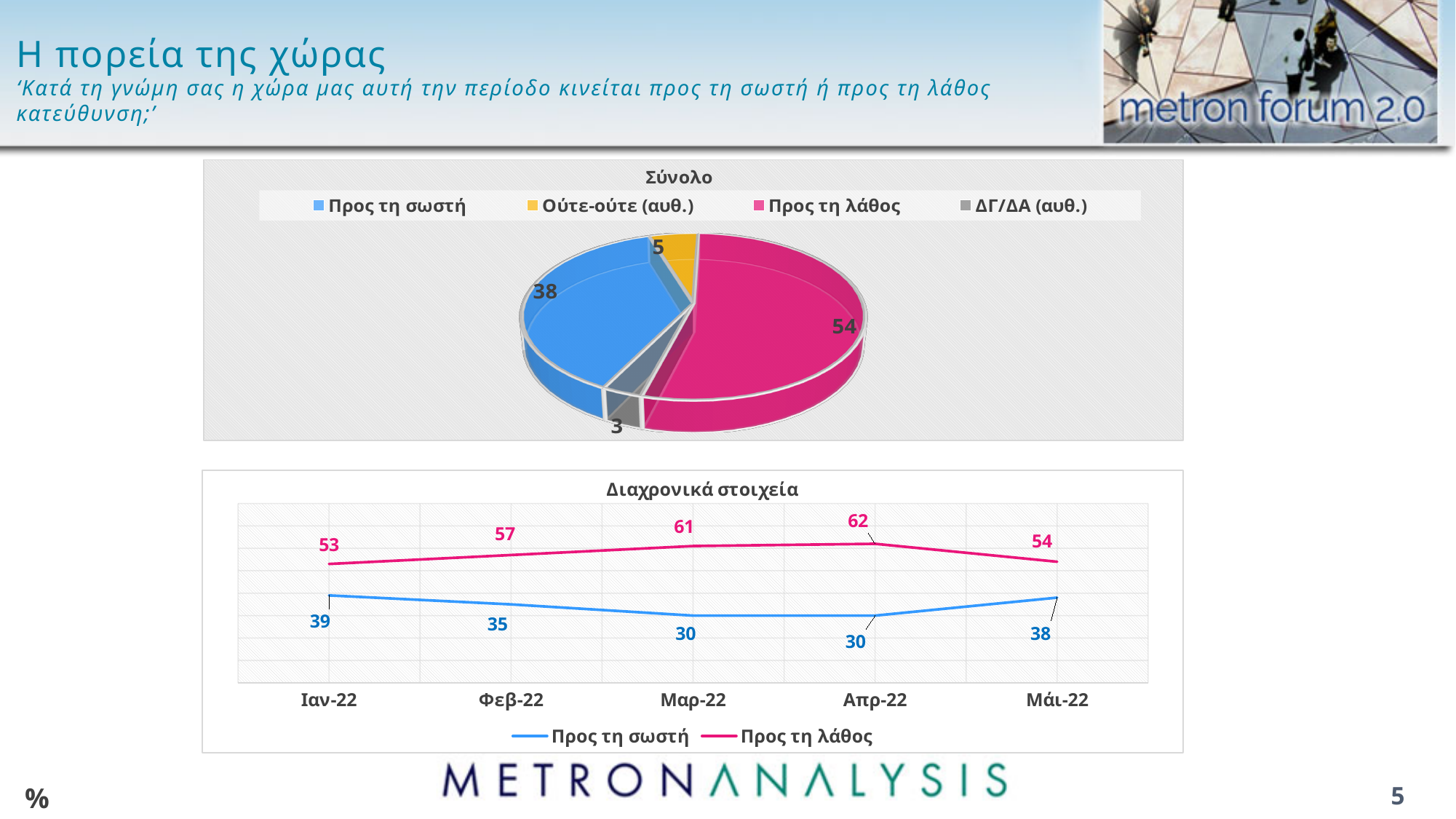
In the 'Σύνολο' pie chart, which category has the smallest slice? ΔΓ/ΔΑ (αυθ.) In the 'Διαχρονικά στοιχεία' chart, what is the value for 'Προς τη λάθος' in Απρ-22? 62 How many categories does the legend of the 'Σύνολο' pie chart list? 4 In the 'Διαχρονικά στοιχεία' chart, what is the difference between 'Προς τη λάθος' and 'Προς τη σωστή' in Μαρ-22? 31 In the 'Σύνολο' pie chart, what is the value for 'Προς τη λάθος'? 54 In the 'Διαχρονικά στοιχεία' chart, what is the value for 'Προς τη σωστή' in Φεβ-22? 35 In the 'Σύνολο' pie chart, what is the value for 'Ούτε-ούτε (αυθ.)'? 5 In the 'Διαχρονικά στοιχεία' chart, in which month does 'Προς τη λάθος' reach its highest value? Απρ-22 In the 'Σύνολο' pie chart, which category has the largest slice? Προς τη λάθος How many time points are shown on the x axis of the 'Διαχρονικά στοιχεία' chart? 5 What type of chart is 'Διαχρονικά στοιχεία'? Line chart In the 'Σύνολο' pie chart, what is the difference between 'Προς τη λάθος' and 'Προς τη σωστή'? 16